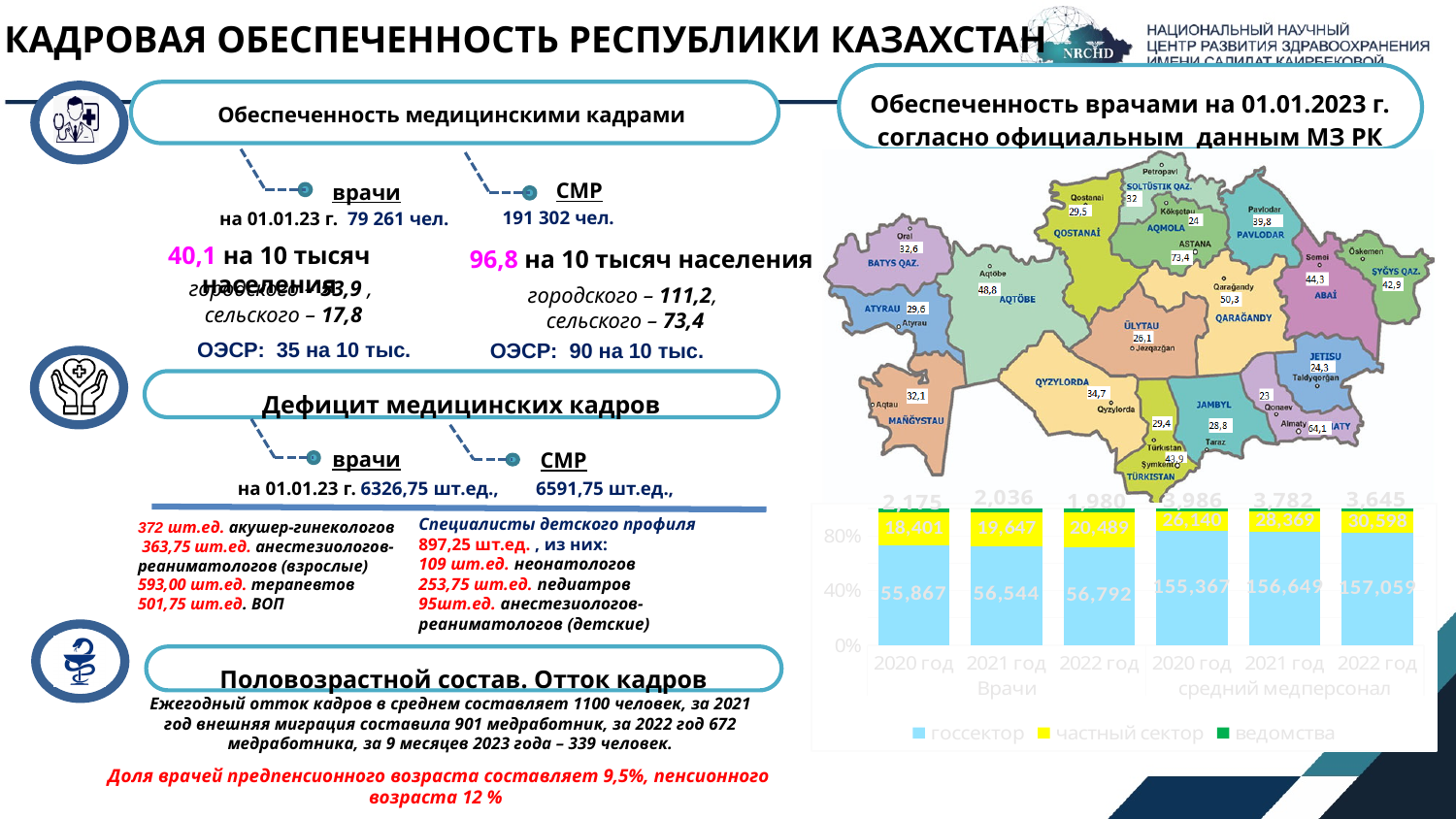
In the bar chart, what is the частный сектор value for Врачи in 2022 год? 20,489 In the bar chart, what is the ведомства value for средний медперсонал in 2021 год? 3,782 In the bar chart, what is the госсектор value for средний медперсонал in 2022 год? 157,059 How many series does the legend of the bar chart list? 3 In the bar chart, what is the difference between the госсектор values for Врачи in 2022 год and 2020 год? 925 What kind of chart is shown at the bottom right of the slide? stacked bar chart In the bar chart, which is larger: the частный сектор value for Врачи in 2021 год or in 2020 год? 2021 год In the bar chart, what is the госсектор value for Врачи in 2020 год? 55,867 In the bar chart, which category has the highest частный сектор value? 2022 год (средний медперсонал) In the bar chart, do the госсектор values for Врачи rise or fall from 2020 год to 2022 год? rise How many categories are shown along the x axis of the bar chart? 6 In the bar chart, which category has the lowest ведомства value? 2022 год (Врачи)